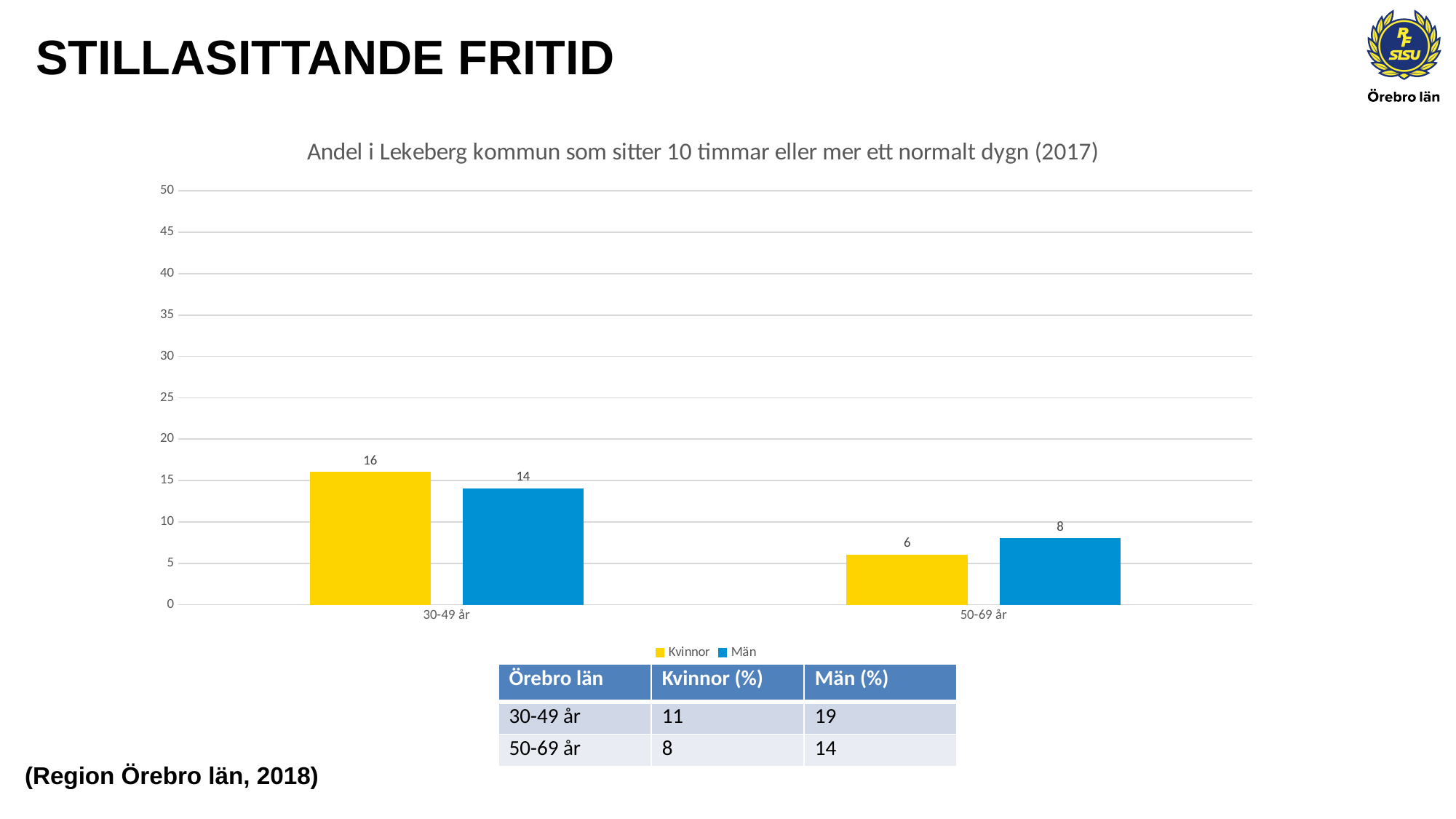
What kind of chart is shown on the slide? Bar chart What is the value for Kvinnor in the 50-69 år category? 6 Which bar has the highest value in the chart? Kvinnor, 30-49 år What is the difference between the Kvinnor value for 30-49 år and the Kvinnor value for 50-69 år? 10 Which is larger for 50-69 år, Kvinnor or Män? Män How many series does the legend list? 2 What is the value for Män in the 50-69 år category? 8 What is the value for Män in the 30-49 år category? 14 How many age categories are shown on the x axis? 2 What is the value for Kvinnor in the 30-49 år category? 16 Which bar has the lowest value in the chart? Kvinnor, 50-69 år What is the difference between the Kvinnor and Män values for 30-49 år? 2